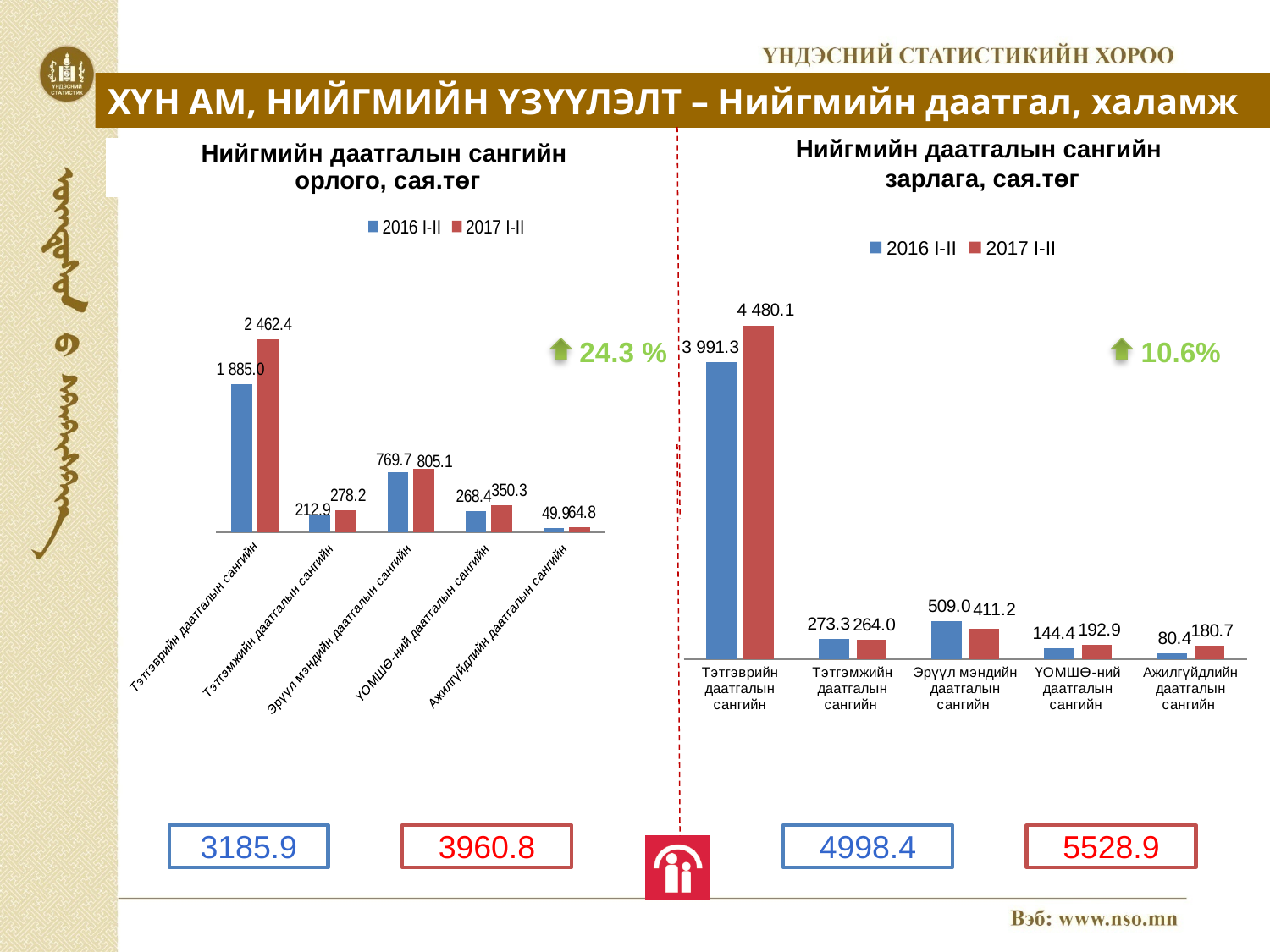
In the right chart (Нийгмийн даатгалын сангийн зарлага), what is the 2016 I-II value for Ажилгүйдлийн даатгалын сангийн? 80.4 In the left chart (Нийгмийн даатгалын сангийн орлого), what is the 2016 I-II value for Эрүүл мэндийн даатгалын сангийн? 769.7 In the right chart (Нийгмийн даатгалын сангийн зарлага), which is larger for Тэтгэмжийн даатгалын сангийн: the 2016 I-II value or the 2017 I-II value? 2016 I-II What type of chart is the left chart (Нийгмийн даатгалын сангийн орлого)? Bar chart In the right chart (Нийгмийн даатгалын сангийн зарлага), what is the 2017 I-II value for Тэтгэврийн даатгалын сангийн? 4 480.1 In the right chart (Нийгмийн даатгалын сангийн зарлага), which category has the highest 2017 I-II value? Тэтгэврийн даатгалын сангийн In the left chart (Нийгмийн даатгалын сангийн орлого), what is the 2017 I-II value for Тэтгэврийн даатгалын сангийн? 2 462.4 How many categories are shown on the x axis of the left chart (Нийгмийн даатгалын сангийн орлого)? 5 How many series does the legend of the right chart (Нийгмийн даатгалын сангийн зарлага) list? 2 In the left chart (Нийгмийн даатгалын сангийн орлого), which category has the lowest 2016 I-II value? Ажилгүйдлийн даатгалын сангийн In the left chart (Нийгмийн даатгалын сангийн орлого), what is the difference between the 2017 I-II and 2016 I-II values for ҮОМШӨ-ний даатгалын сангийн? 81.9 In the right chart (Нийгмийн даатгалын сангийн зарлага), what is the difference between the 2016 I-II and 2017 I-II values for Эрүүл мэндийн даатгалын сангийн? 97.8